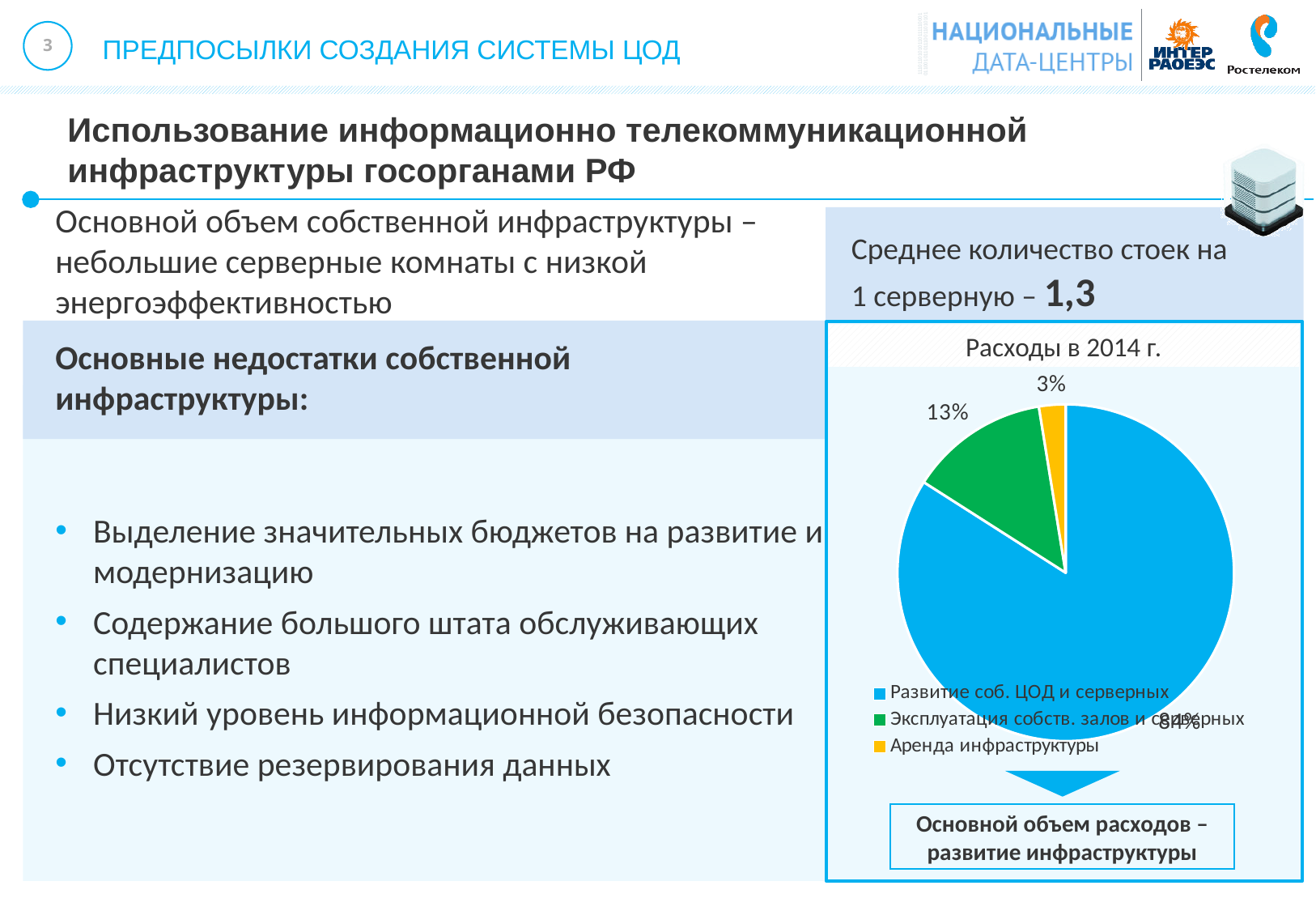
How many slices does the pie chart "Расходы в 2014 г." have? 3 What is the title of the pie chart on the slide? Расходы в 2014 г. How many entries does the legend of the pie chart "Расходы в 2014 г." list? 3 In the pie chart "Расходы в 2014 г.", what is the difference in percentage points between the "Эксплуатация собств. залов и серверных" slice and the "Аренда инфраструктуры" slice? 10 In the pie chart "Расходы в 2014 г.", which is larger: the slice for "Эксплуатация собств. залов и серверных" or the slice for "Аренда инфраструктуры"? Эксплуатация собств. залов и серверных In the pie chart "Расходы в 2014 г.", what share is labelled for "Эксплуатация собств. залов и серверных"? 13% In the pie chart "Расходы в 2014 г.", which category has the largest slice? Развитие соб. ЦОД и серверных What type of chart is shown under the title "Расходы в 2014 г."? pie chart In the pie chart "Расходы в 2014 г.", what share is labelled for "Аренда инфраструктуры"? 3% In the pie chart "Расходы в 2014 г.", what colour is the slice for "Аренда инфраструктуры"? yellow In the pie chart "Расходы в 2014 г.", which category has the smallest slice? Аренда инфраструктуры